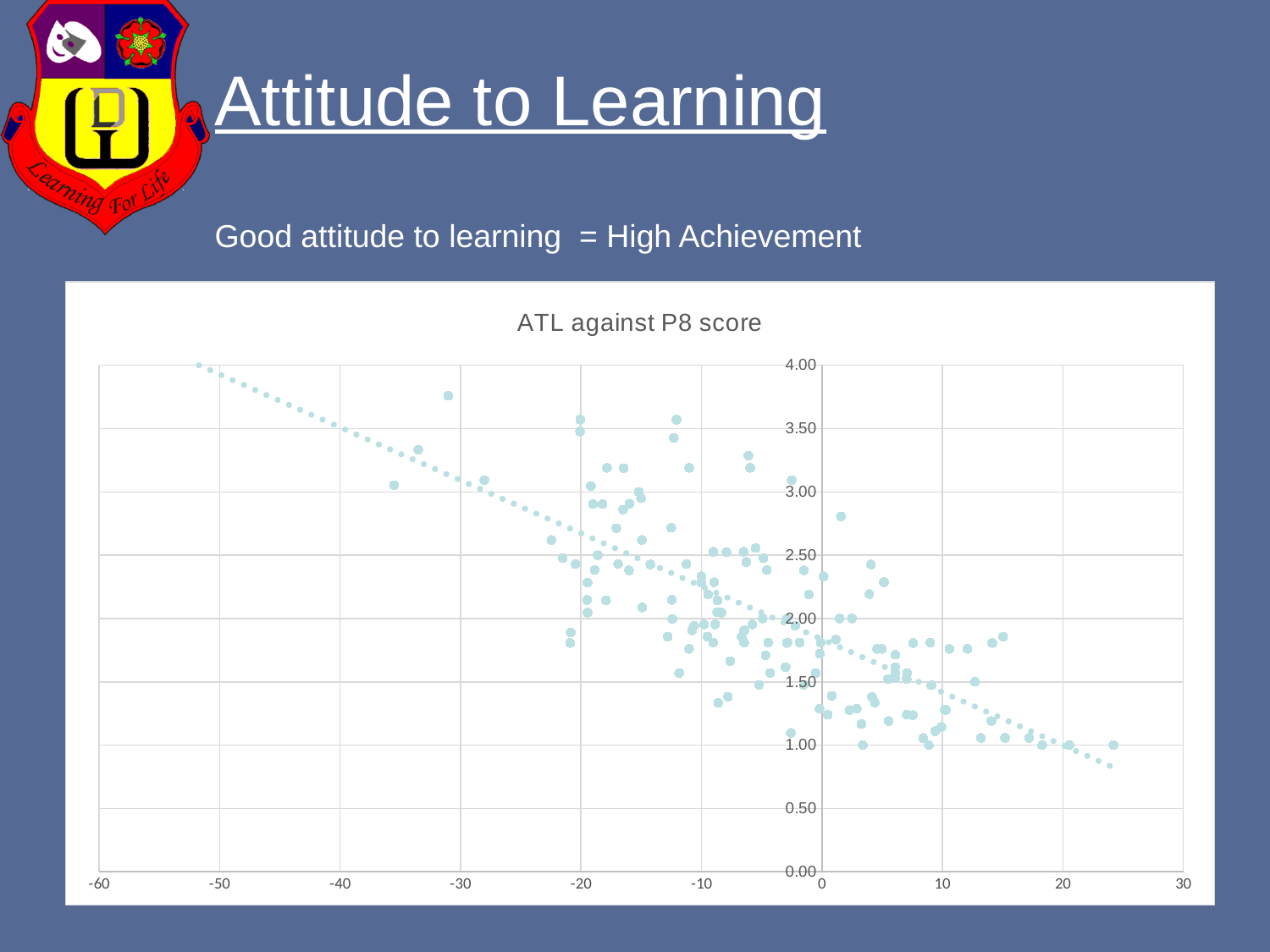
Is the value of the dotted trend line at x = -50 greater or less than 3.50? greater Does the dotted trend line slope upward or downward from left to right? Downward What kind of chart is shown on the slide? Scatter chart What is the title of the chart? ATL against P8 score Is the highest plotted point on the chart greater or less than 3.50? greater Is the value of the dotted trend line at x = 20 greater or less than 1.50? less As the x-axis value increases from -60 to 30, do the plotted points generally rise or fall? Fall What is the highest value shown on the y-axis? 4.00